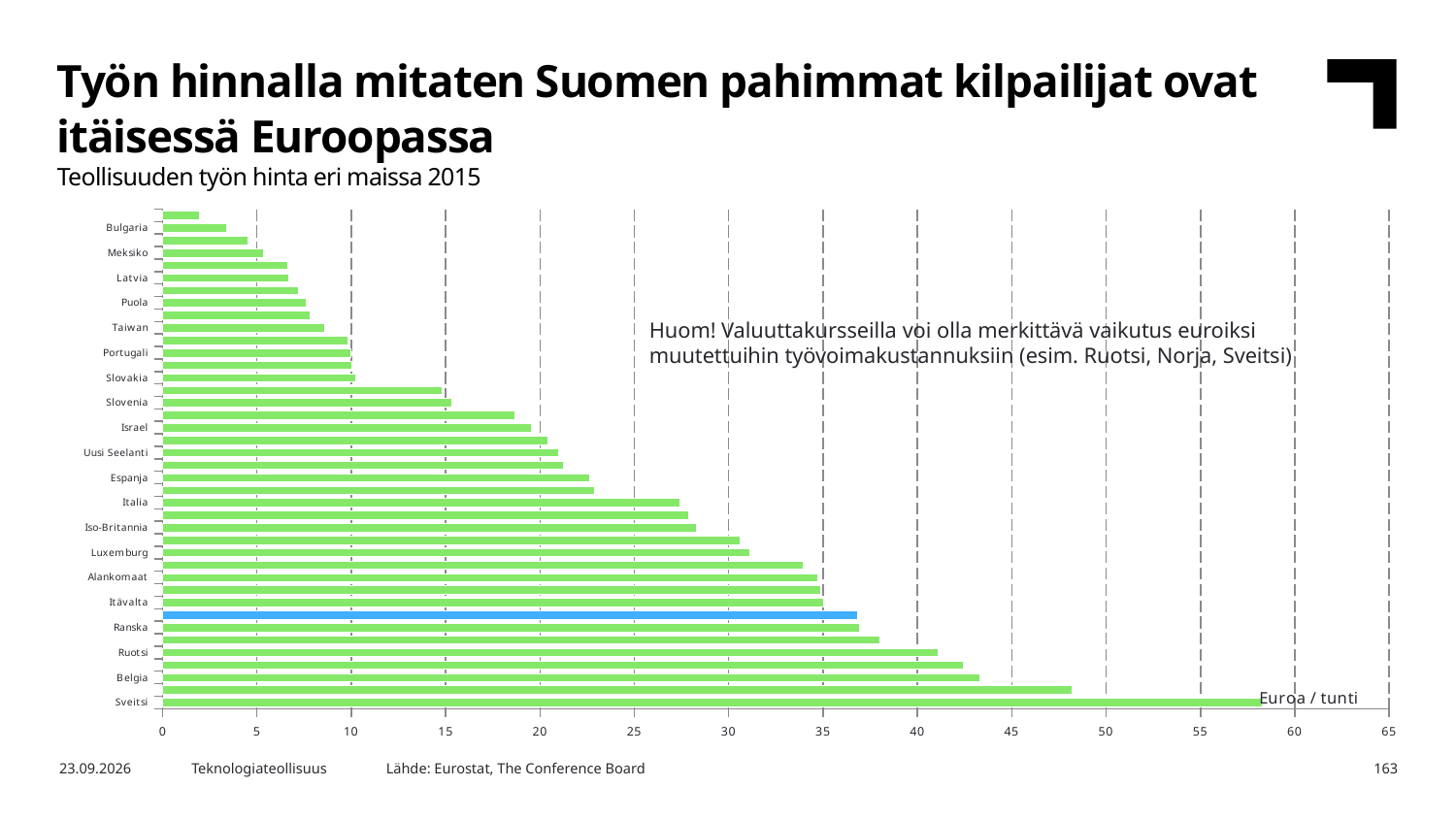
Which labelled country has the highest labour cost in the chart? Sveitsi Is the value for Espanja greater or less than 20? greater Do the bar values increase or decrease going from the top of the chart to the bottom? increase Is the value for Belgia greater or less than 40? greater Is the value for Sveitsi greater or less than 55? greater What kind of chart is shown on the slide? bar chart Which has the larger value, Luxemburg or Portugali? Luxemburg What unit is shown next to the longest bar in the chart? Euroa / tunti Which has the larger value, Belgia or Ruotsi? Belgia